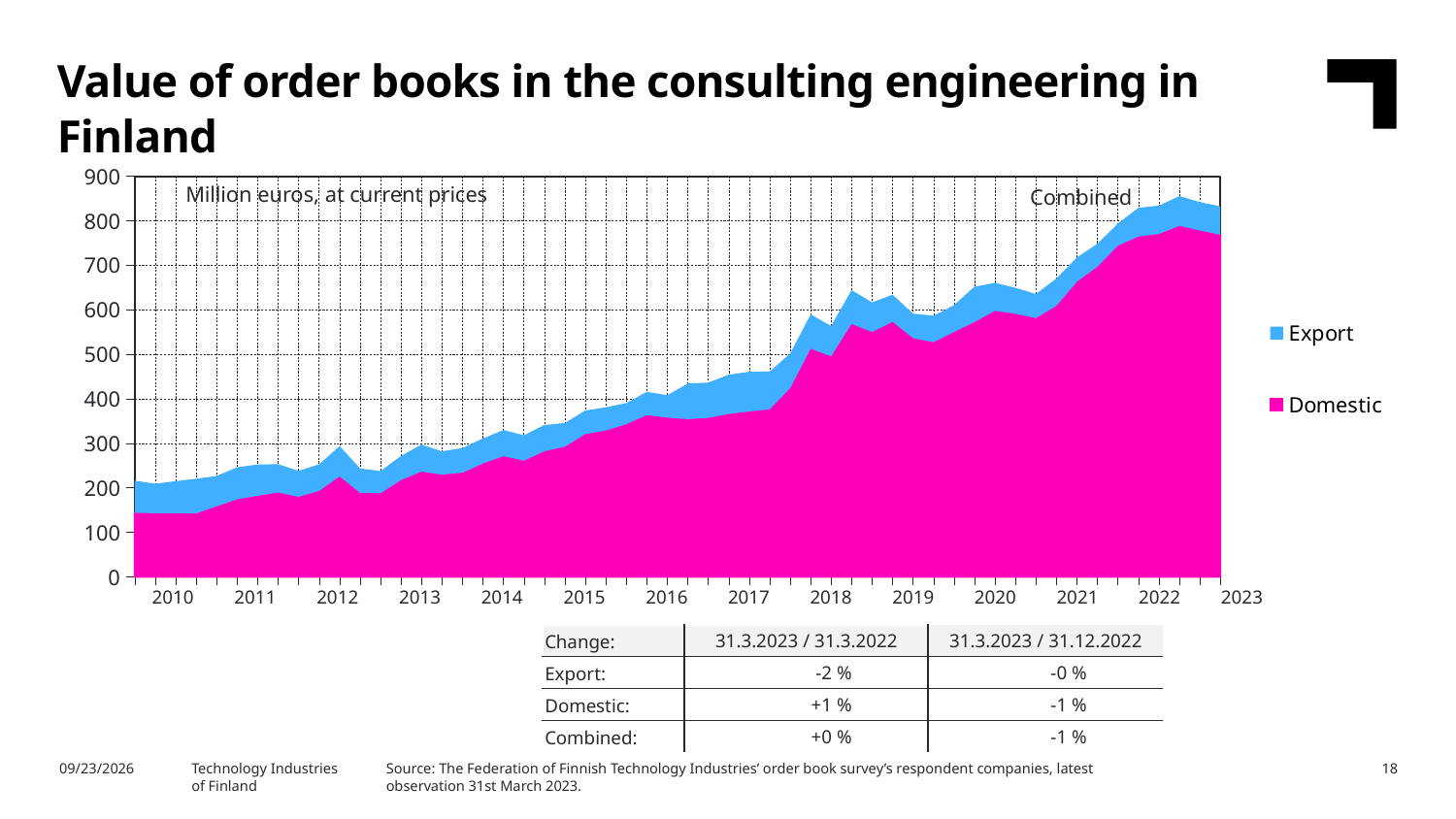
Which series, Export or Domestic, is larger in 2022? Domestic Is the Domestic value at the start of 2010 greater or less than 200? less In which year does the combined value reach its highest level? 2022 How many year labels are shown on the x axis? 14 What are the two series named in the legend? Export and Domestic What kind of chart is shown on the slide? Area chart Is the combined value in 2022 greater or less than 700? greater Does the combined value of order books generally rise or fall from 2010 to 2023? Rise What unit is stated in the chart's annotation? Million euros, at current prices Is the combined value at the start of 2010 greater or less than 300? less How many series does the legend list? 2